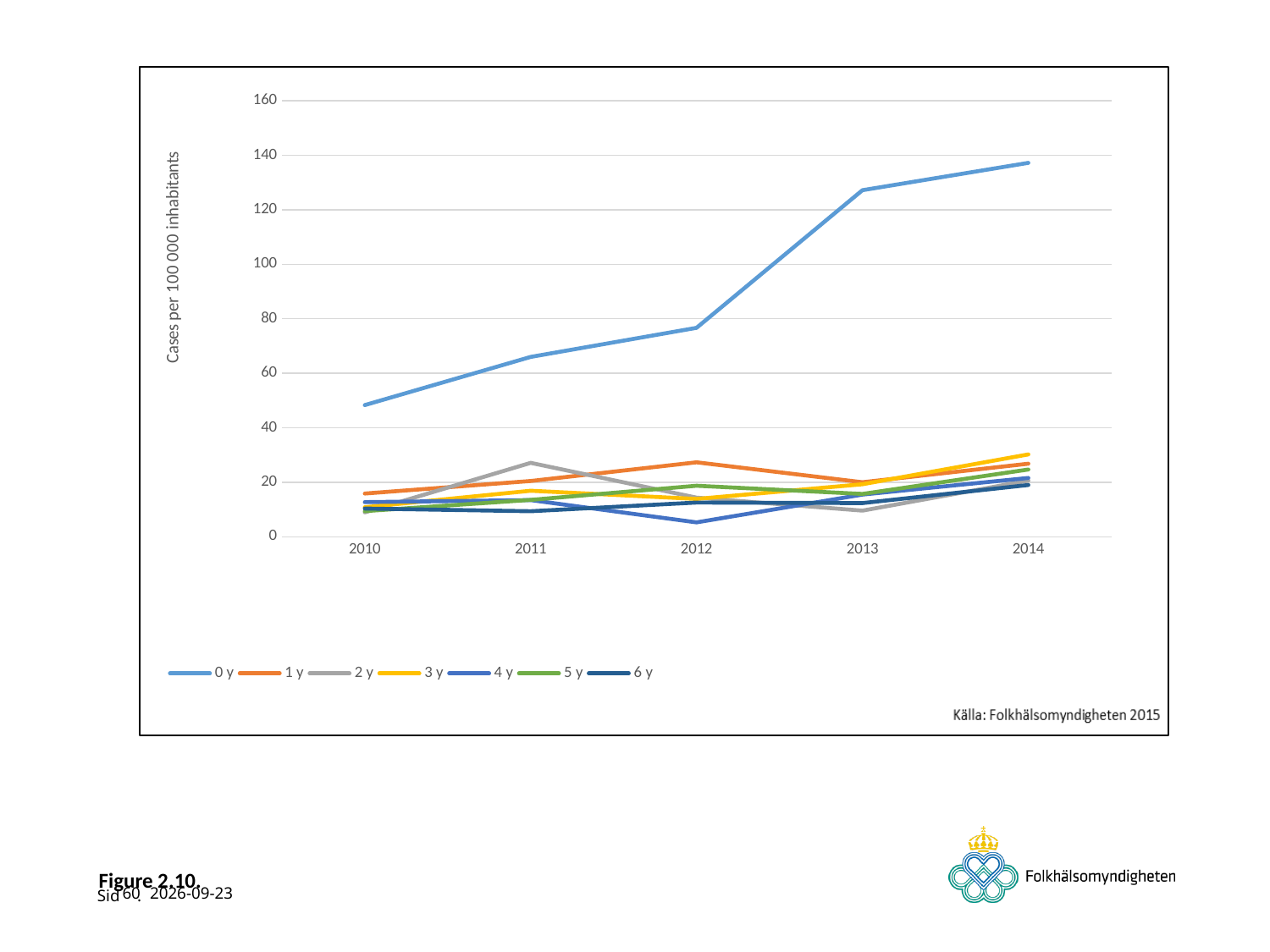
How many years are shown along the x axis? 5 Which series has the lowest value in 2012? 4 y Is the value for 0 y in 2010 greater or less than 40? greater In 2014, which is larger: the value for 0 y or the value for 1 y? 0 y What is the title of the y axis? Cases per 100 000 inhabitants Does the value for the 0 y series rise or fall from 2010 to 2014? rise How many series does the legend list? 7 What kind of chart is shown on the slide? line chart Which series has the highest value in 2014? 0 y Is the value for 0 y in 2014 greater or less than 120? greater Is the value for 0 y in 2012 greater or less than 80? less